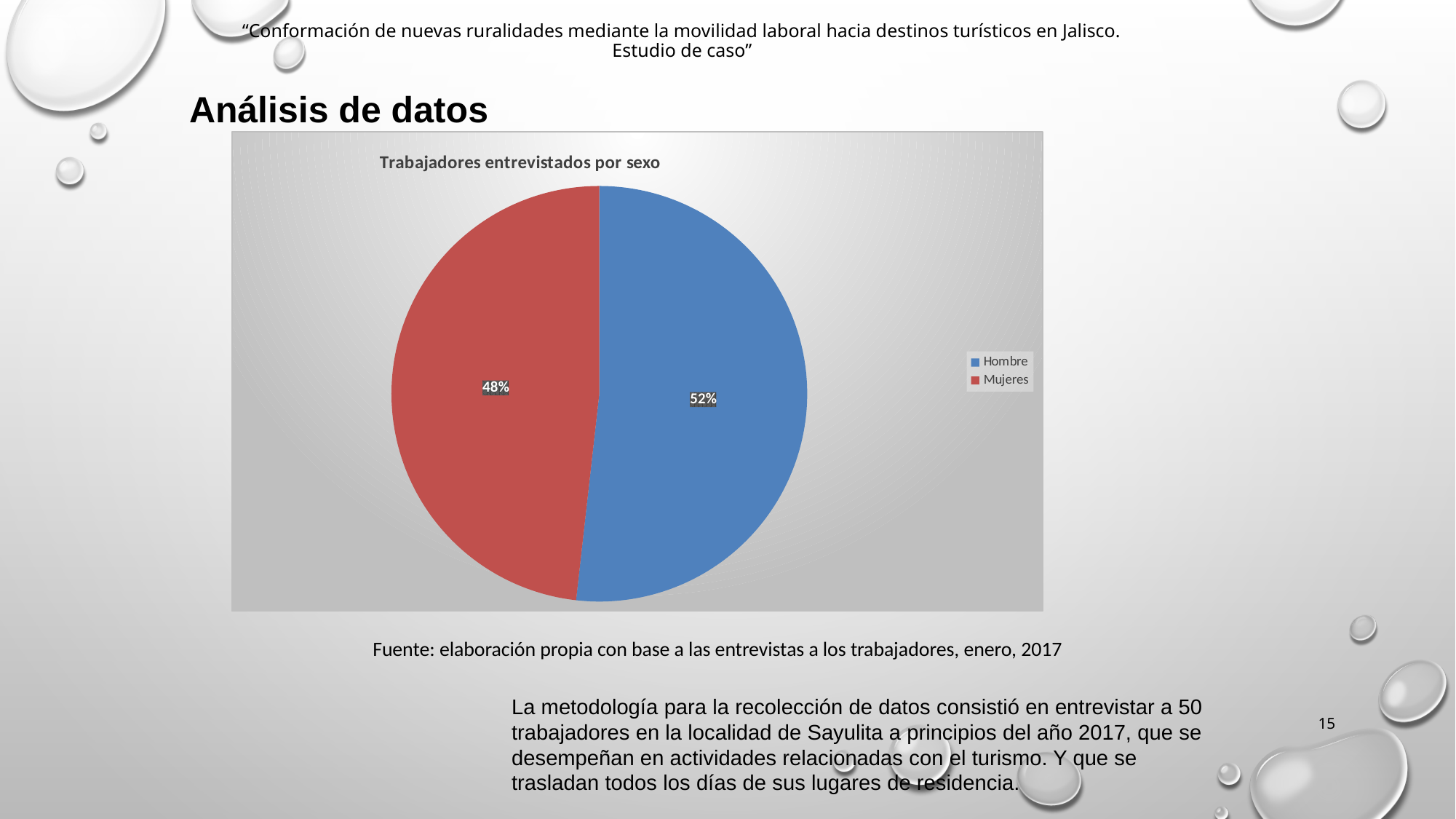
What kind of chart is shown on the slide? Pie chart What is the difference in percentage points between the Hombre and Mujeres slices? 4 What share of the pie does Hombre represent? 52% Which category has the smallest slice of the pie? Mujeres What share of the pie does Mujeres represent? 48% Which category has the largest slice of the pie? Hombre How many entries does the legend list? 2 What colour is the Mujeres slice? Red How many categories are shown in the pie chart? 2 Which slice is larger, Hombre or Mujeres? Hombre What is the title of the chart? Trabajadores entrevistados por sexo